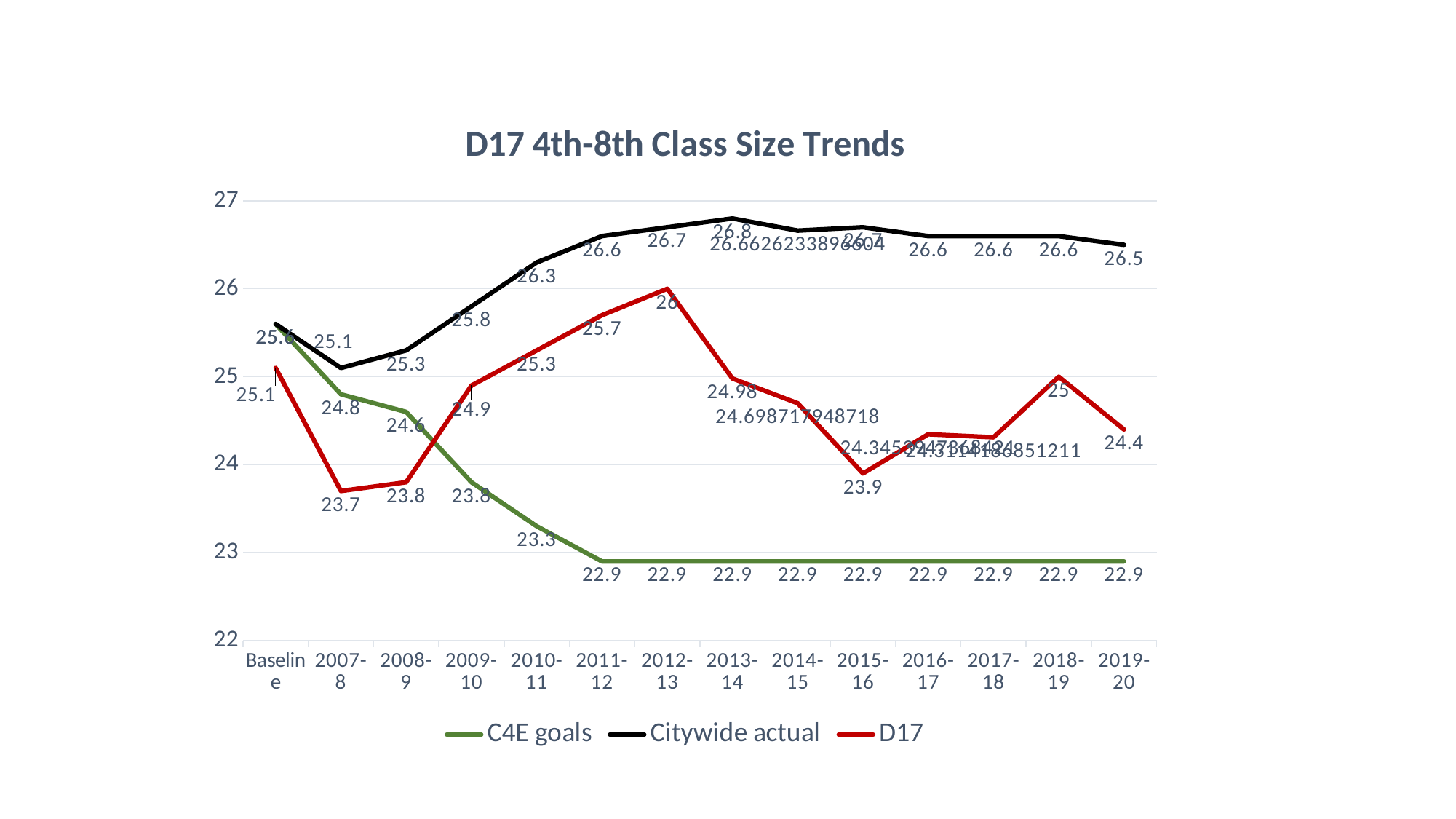
What is the D17 value for 2015-16? 23.9 What is the Citywide actual value for 2010-11? 26.3 In which year does the D17 series reach its lowest value? 2007-8 What is the difference between the Citywide actual and D17 values in 2019-20? 2.1 How many categories are shown on the x axis? 14 How many series does the legend list? 3 What is the D17 value for 2012-13? 26 What kind of chart is this? Line chart What is the C4E goals value for 2009-10? 23.8 In which year does the D17 series reach its highest value? 2012-13 What is the Citywide actual value for 2019-20? 26.5 In 2011-12, which is larger: Citywide actual or D17? Citywide actual